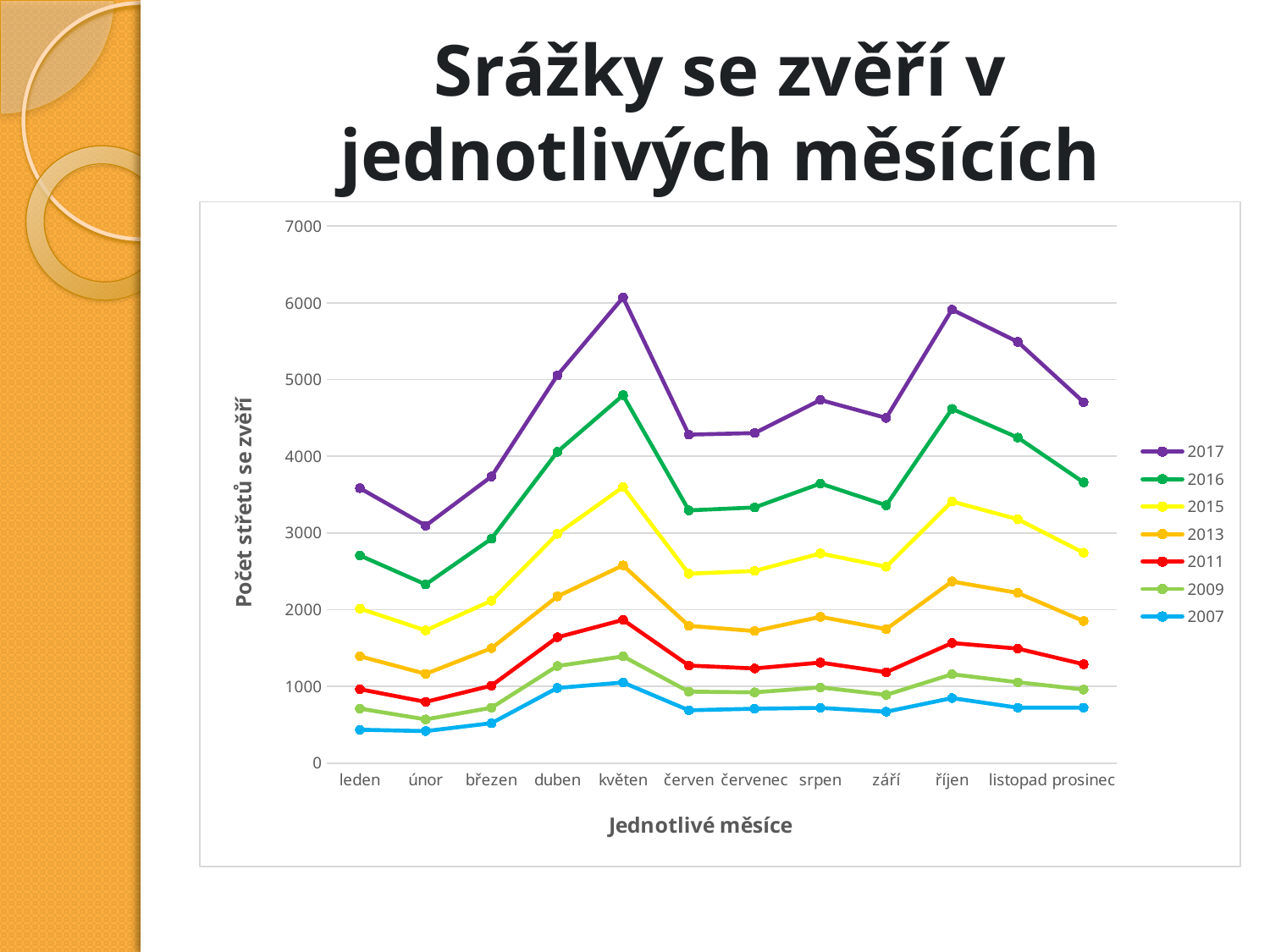
What is the title of the vertical axis? Počet střetů se zvěří In which month does the 2017 series have its lowest value? únor In which month does the 2017 series reach its highest value? květen What kind of chart is shown on the slide? line chart Which series has the highest values across all months? 2017 How many months are shown on the x axis? 12 Is the value for 2007 in leden greater or less than 1000? less How many series does the legend list? 7 Is the value for 2013 in květen greater or less than 2000? greater Do the values for 2017 rise or fall from květen to červen? fall Is the value for 2016 in květen greater or less than 5000? less Which is larger in leden: the value for 2016 or the value for 2015? 2016